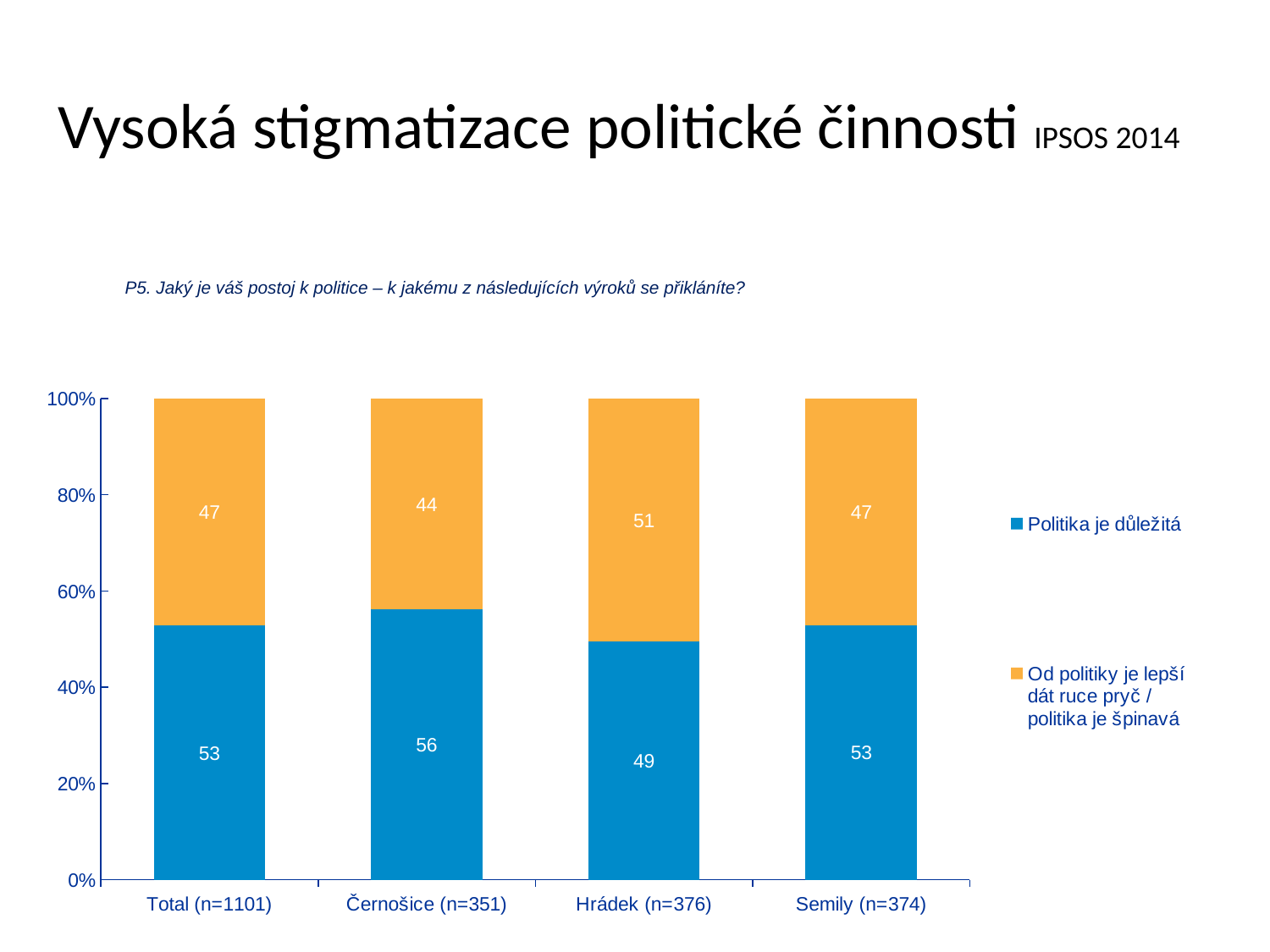
What is the value for "Politika je důležitá" in Total (n=1101)? 53 What is the value for "Od politiky je lepší dát ruce pryč / politika je špinavá" in Hrádek (n=376)? 51 What kind of chart is shown on the slide? Stacked bar chart Which category has the highest value for "Politika je důležitá"? Černošice (n=351) How many categories are shown on the x axis? 4 Which is larger in Semily (n=374): "Politika je důležitá" or "Od politiky je lepší dát ruce pryč / politika je špinavá"? Politika je důležitá What is the total of the stacked bar for Hrádek (n=376)? 100 Which colour represents "Politika je důležitá" in the chart? Blue Which category has the lowest value for "Politika je důležitá"? Hrádek (n=376) What is the difference between the "Politika je důležitá" values for Černošice (n=351) and Hrádek (n=376)? 7 How many series does the legend list? 2 What is the value for "Politika je důležitá" in Černošice (n=351)? 56